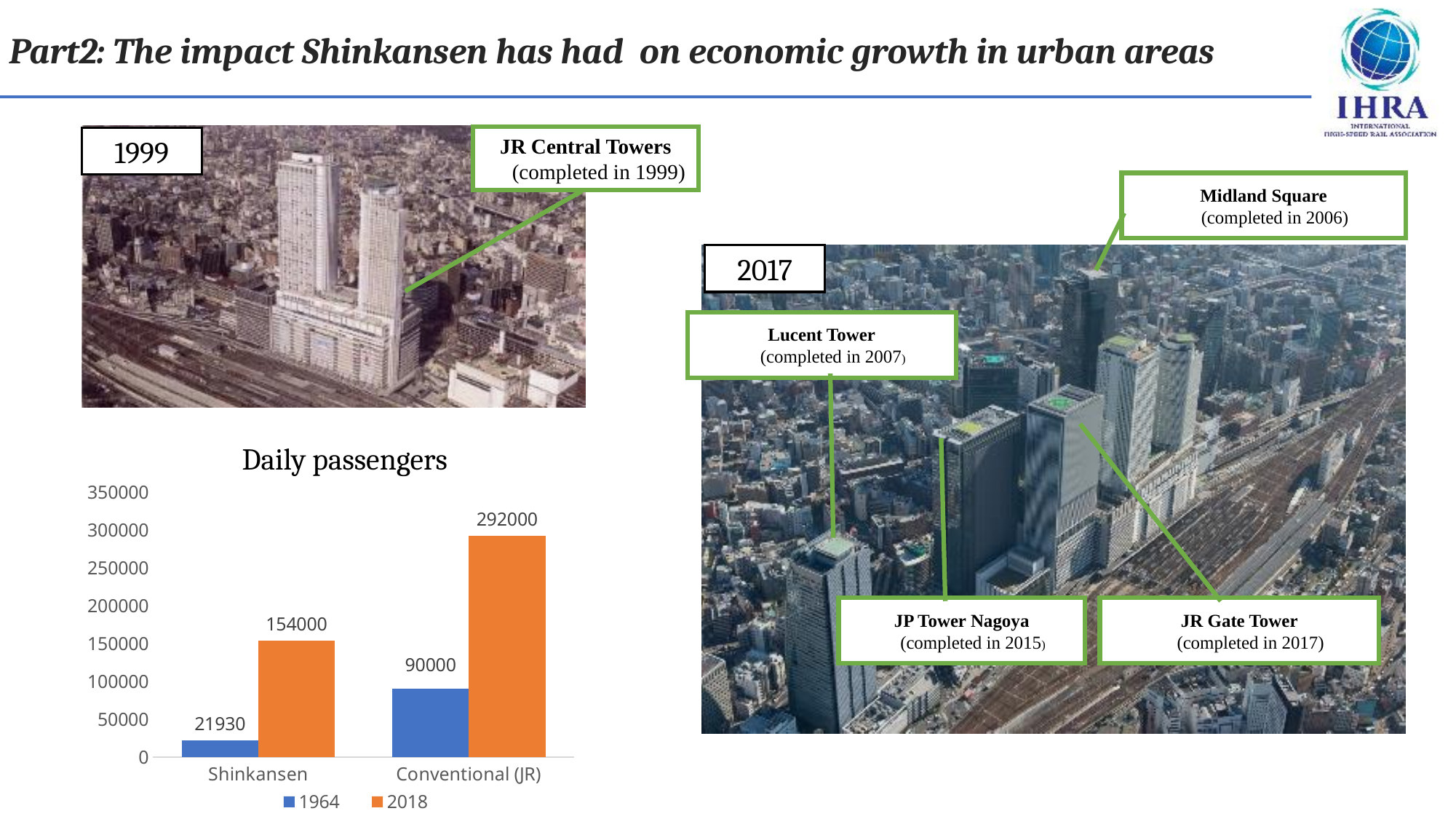
How many series does the legend of the Daily passengers chart list? 2 How many categories are shown on the x axis of the Daily passengers chart? 2 What kind of chart is the Daily passengers chart? Bar chart Which is larger in the Daily passengers chart: Shinkansen in 2018 or Conventional (JR) in 1964? Shinkansen in 2018 What is the difference between the 2018 and 1964 values for Shinkansen in the Daily passengers chart? 132070 What is the value for Shinkansen in 2018 in the Daily passengers chart? 154000 What is the value for Conventional (JR) in 1964 in the Daily passengers chart? 90000 Which bar has the lowest value in the Daily passengers chart? Shinkansen in 1964 What is the value for Conventional (JR) in 2018 in the Daily passengers chart? 292000 Which bar has the highest value in the Daily passengers chart? Conventional (JR) in 2018 What is the difference between the 2018 and 1964 values for Conventional (JR) in the Daily passengers chart? 202000 What is the value for Shinkansen in 1964 in the Daily passengers chart? 21930